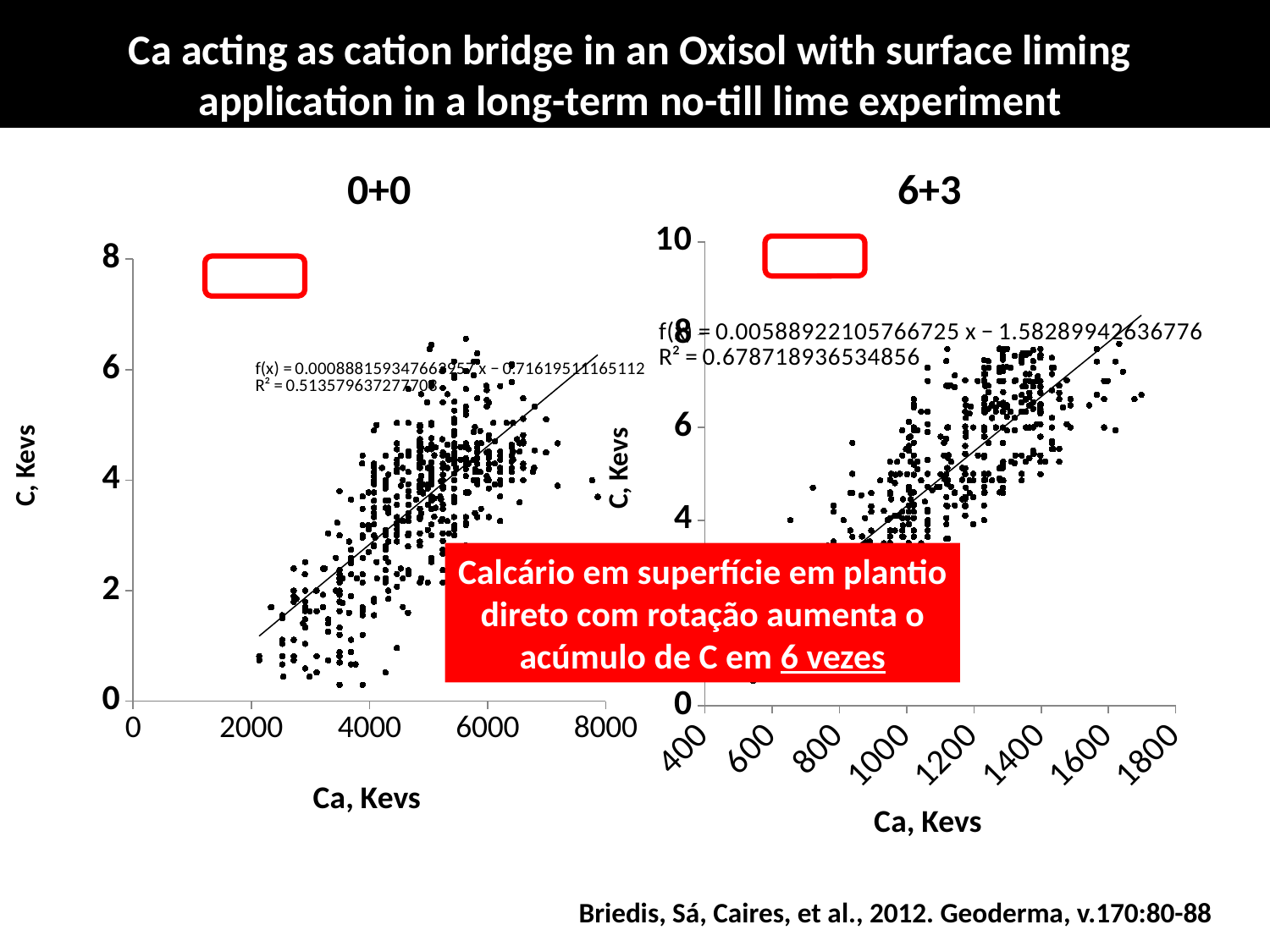
In the "6+3" chart on the right, what is the R² value of the fitted line? 0.678718936534856 What is the highest tick value on the y axis of the "6+3" chart on the right? 10 What is the label of the x axis on the "6+3" chart on the right? Ca, Kevs In the "6+3" chart on the right, is the R² of the fitted line greater or less than 0.6? greater In the "6+3" chart on the right, does C, Kevs rise or fall as Ca, Kevs increases? rise In the "0+0" chart on the left, does C, Kevs rise or fall as Ca, Kevs increases? rise How many scatter charts are shown on the slide? 2 In the "6+3" chart on the right, what is the intercept of the fitted line f(x)? −1.58289942636776 What kind of chart is the "0+0" chart on the left? scatter chart In the "0+0" chart on the left, is the R² of the fitted line greater or less than 0.6? less Which chart has the higher R² for its fitted line, "0+0" or "6+3"? 6+3 In the "6+3" chart on the right, what is the slope of the fitted line f(x)? 0.00588922105766725